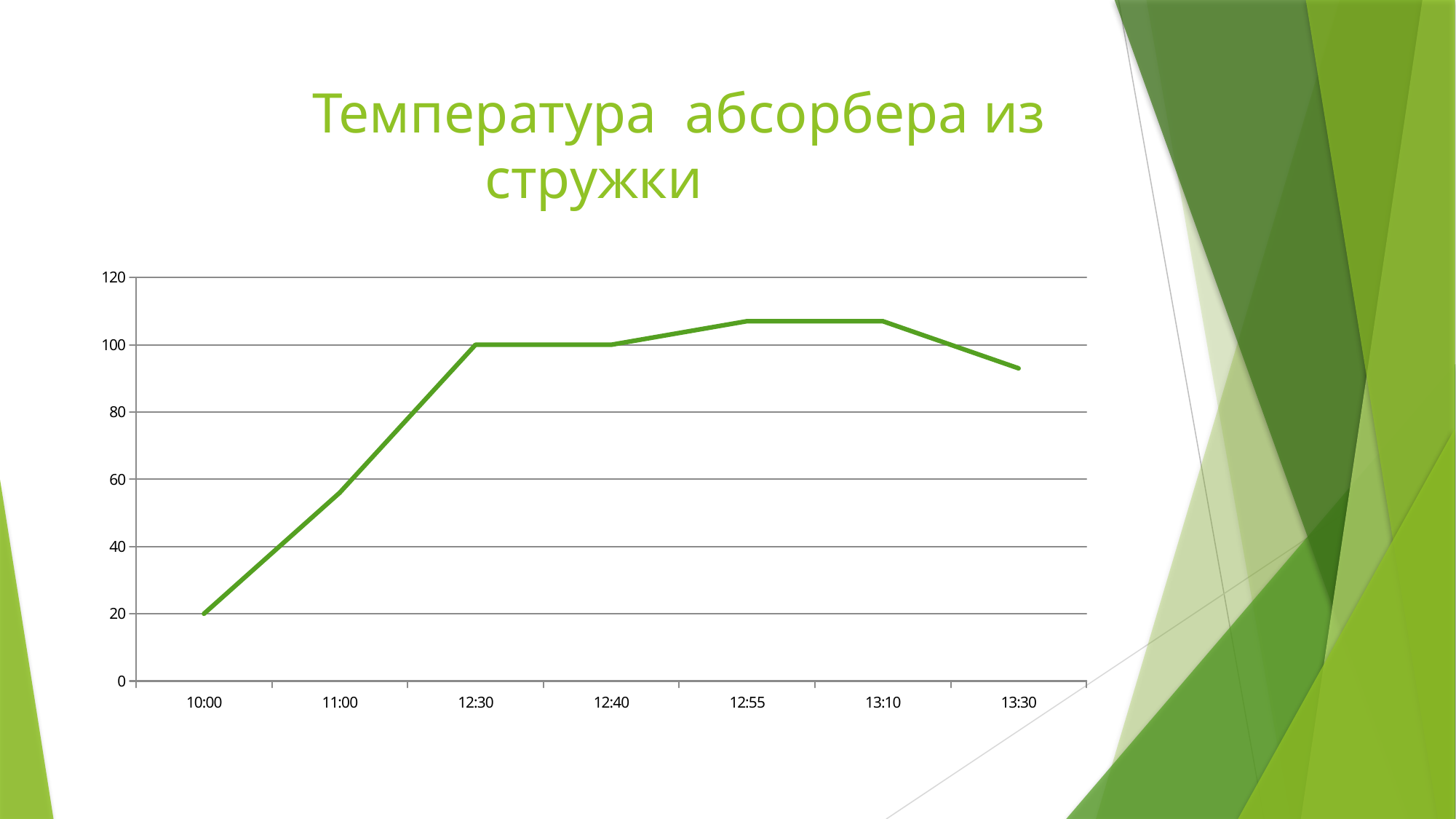
What is the value at 12:30? 100 Is the value at 13:30 greater or less than 100? less Which is larger, the value at 13:10 or the value at 13:30? 13:10 Is the value at 11:00 greater or less than 60? less What kind of chart is shown on the slide? line chart Is the value at 12:55 greater or less than 100? greater What is the value at 10:00? 20 At which time is the value lowest? 10:00 How many time points are plotted on the x axis? 7 What is the value at 12:40? 100 What is the difference between the value at 12:30 and the value at 10:00? 80 What is the title of the chart? Температура абсорбера из стружки